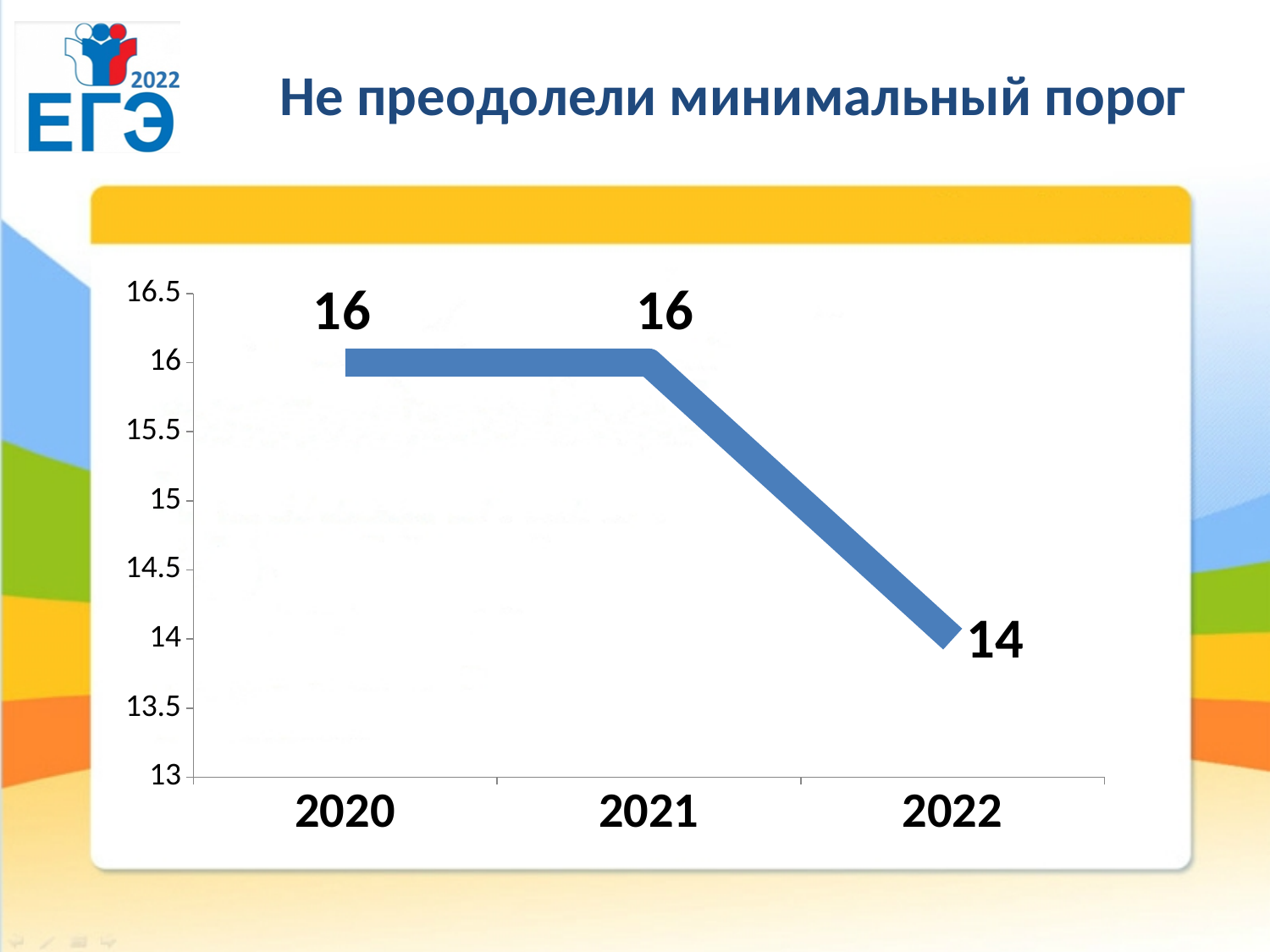
What is the value for 2021? 16 Do the values rise or fall from 2021 to 2022? fall Is the value for 2022 greater or less than 15? less What is the value for 2022? 14 Which is larger, the value for 2020 or the value for 2022? 2020 What is the value for 2020? 16 Which year has the lowest value? 2022 What colour is the line on the chart? blue What kind of chart is shown on the slide? line chart What is the difference between the values for 2021 and 2022? 2 What is the title of the slide? Не преодолели минимальный порог How many years are plotted on the chart? 3